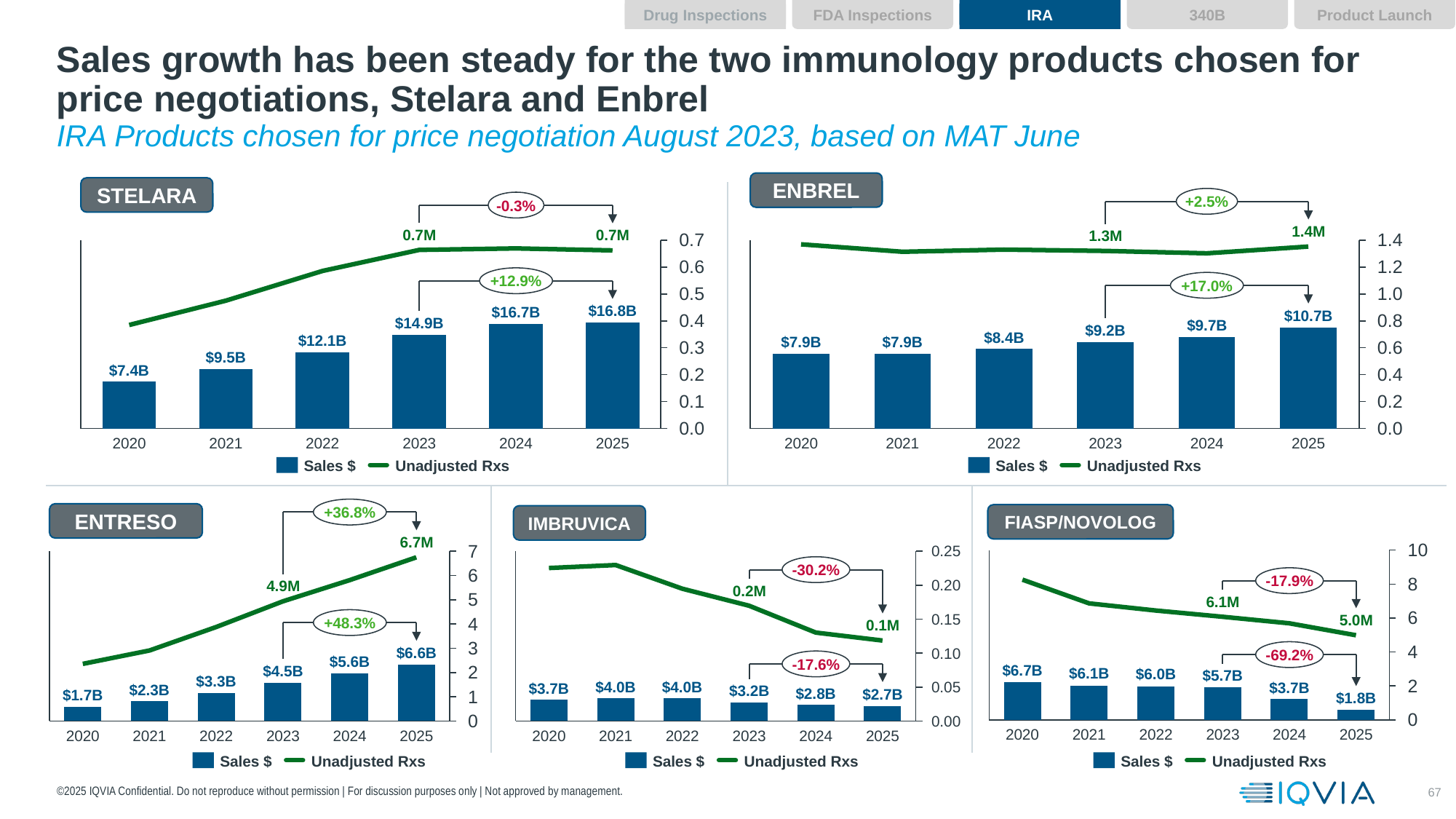
In the ENTRESO chart, which year has the highest Sales $? 2025 In the ENBREL chart, is the Unadjusted Rxs value for 2020 greater or less than 1.0? greater In the STELARA chart, what is the Sales $ value for 2022? $12.1B In the FIASP/NOVOLOG chart, which year has the lowest Sales $? 2025 What kind of chart is the ENTRESO chart? Combined bar and line chart In the FIASP/NOVOLOG chart, do the Sales $ values rise or fall from 2020 to 2025? Fall How many years are shown on the x axis of the ENBREL chart? 6 In the ENTRESO chart, what is the Unadjusted Rxs value shown for 2025? 6.7M In the IMBRUVICA chart, what is the difference in Sales $ between 2021 and 2025? $1.3B In the STELARA chart, which year has higher Sales $, 2023 or 2024? 2024 How many series does the legend of the STELARA chart list? 2 In the ENBREL chart, what is the Sales $ value for 2025? $10.7B